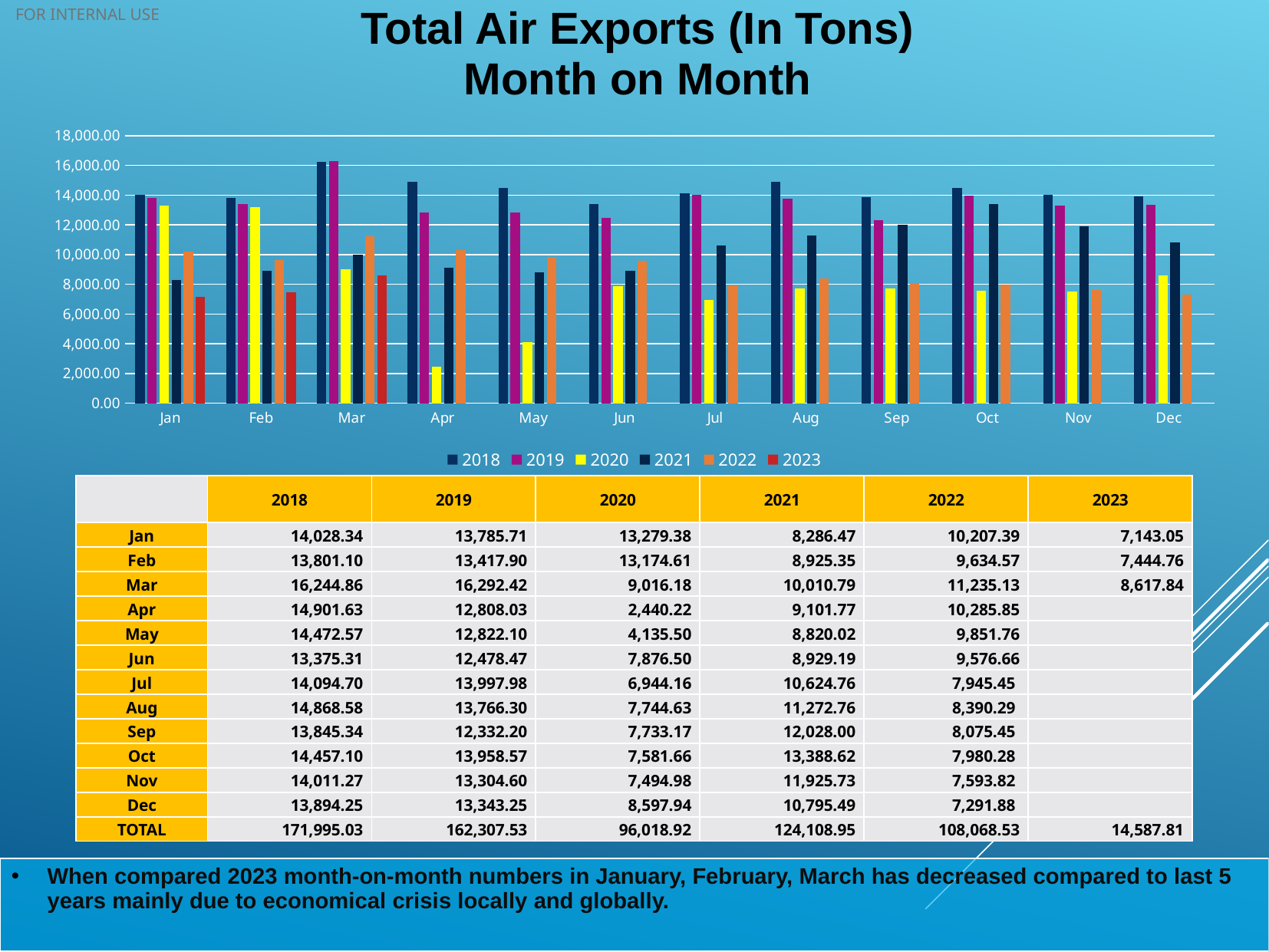
What is the value for 2020 in Apr? 2,440.22 In which month is the 2018 value highest? Mar Do the 2020 values rise or fall from Jan to Apr? fall What kind of chart is shown on the slide? bar chart How many series does the legend list? 6 What is the value for 2023 in Mar? 8,617.84 In Jul, which is larger: the 2021 value or the 2022 value? 2021 In which month is the 2020 value lowest? Apr What is the difference between the 2018 and 2023 values in Jan? 6,885.29 What is the value for 2021 in Oct? 13,388.62 How many months are shown along the x axis? 12 Is the value for 2020 in May greater or less than 6,000.00? less